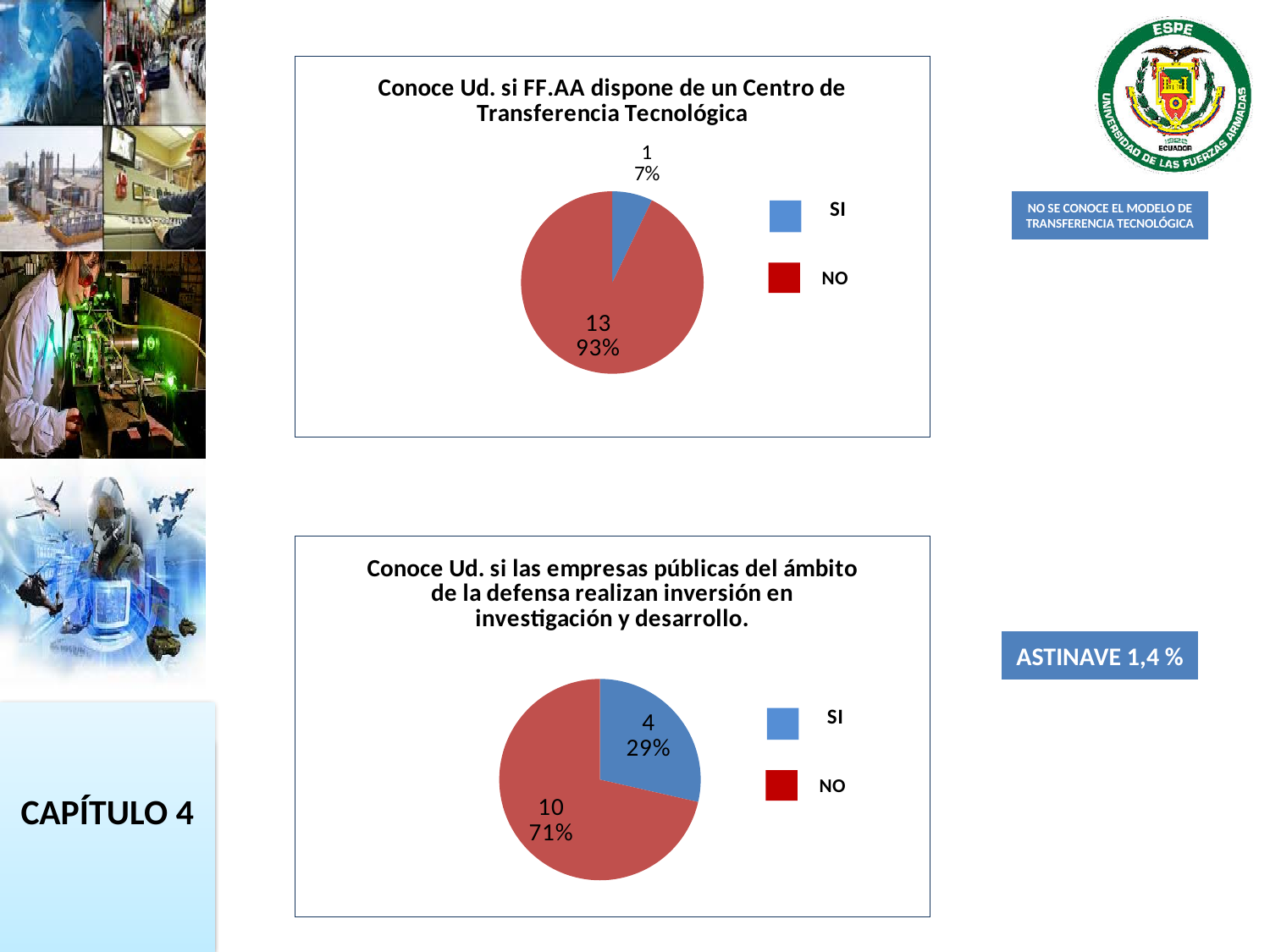
In the bottom chart ("Conoce Ud. si las empresas públicas del ámbito de la defensa realizan inversión en investigación y desarrollo."), which category has the smallest slice? SI In the top chart ("Conoce Ud. si FF.AA dispone de un Centro de Transferencia Tecnológica"), which category has the largest slice? NO In the bottom chart ("Conoce Ud. si las empresas públicas del ámbito de la defensa realizan inversión en investigación y desarrollo."), how many respondents answered SI? 4 In the top chart ("Conoce Ud. si FF.AA dispone de un Centro de Transferencia Tecnológica"), what is the difference in count between NO and SI? 12 In the bottom chart ("Conoce Ud. si las empresas públicas del ámbito de la defensa realizan inversión en investigación y desarrollo."), how many entries does the legend list? 2 In the top chart ("Conoce Ud. si FF.AA dispone de un Centro de Transferencia Tecnológica"), how many respondents answered SI? 1 In the top chart ("Conoce Ud. si FF.AA dispone de un Centro de Transferencia Tecnológica"), what percentage is shown for NO? 93% In the bottom chart ("Conoce Ud. si las empresas públicas del ámbito de la defensa realizan inversión en investigación y desarrollo."), which is larger, the count for SI or the count for NO? NO In the bottom chart ("Conoce Ud. si las empresas públicas del ámbito de la defensa realizan inversión en investigación y desarrollo."), what percentage is shown for NO? 71% In the top chart ("Conoce Ud. si FF.AA dispone de un Centro de Transferencia Tecnológica"), what share of the pie does SI take? 7% In the bottom chart ("Conoce Ud. si las empresas públicas del ámbito de la defensa realizan inversión en investigación y desarrollo."), what is the total number of respondents across both slices? 14 What kind of chart is the top chart ("Conoce Ud. si FF.AA dispone de un Centro de Transferencia Tecnológica")? Pie chart